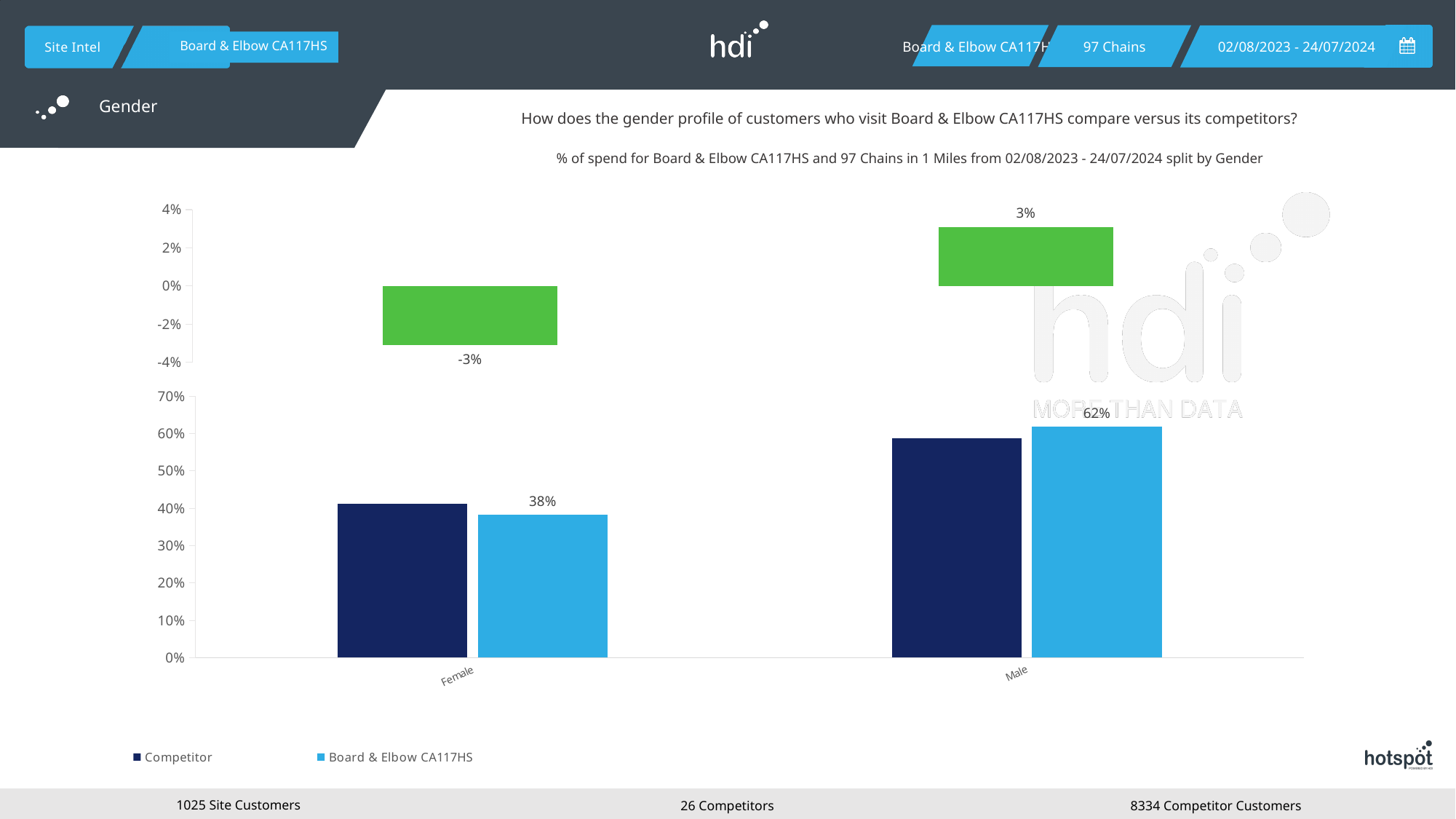
In the bottom chart, for Male, which is larger: the Competitor value or the Board & Elbow CA117HS value? Board & Elbow CA117HS In the bottom chart, what is the value for Board & Elbow CA117HS for Male? 62% How many series does the legend of the bottom chart list? 2 What type of chart is the bottom chart? Bar chart In the bottom chart, which gender has the higher value for Board & Elbow CA117HS? Male In the bottom chart, what is the value for Board & Elbow CA117HS for Female? 38% In the top chart, what is the value shown for Male? 3% In the bottom chart, is the Competitor value for Male greater or less than 60%? less In the bottom chart, what is the difference between the Board & Elbow CA117HS values for Male and Female? 24% How many gender categories are shown on the x axis of the bottom chart? 2 In the top chart, what is the value shown for Female? -3% In the bottom chart, is the Competitor value for Female greater or less than 40%? greater